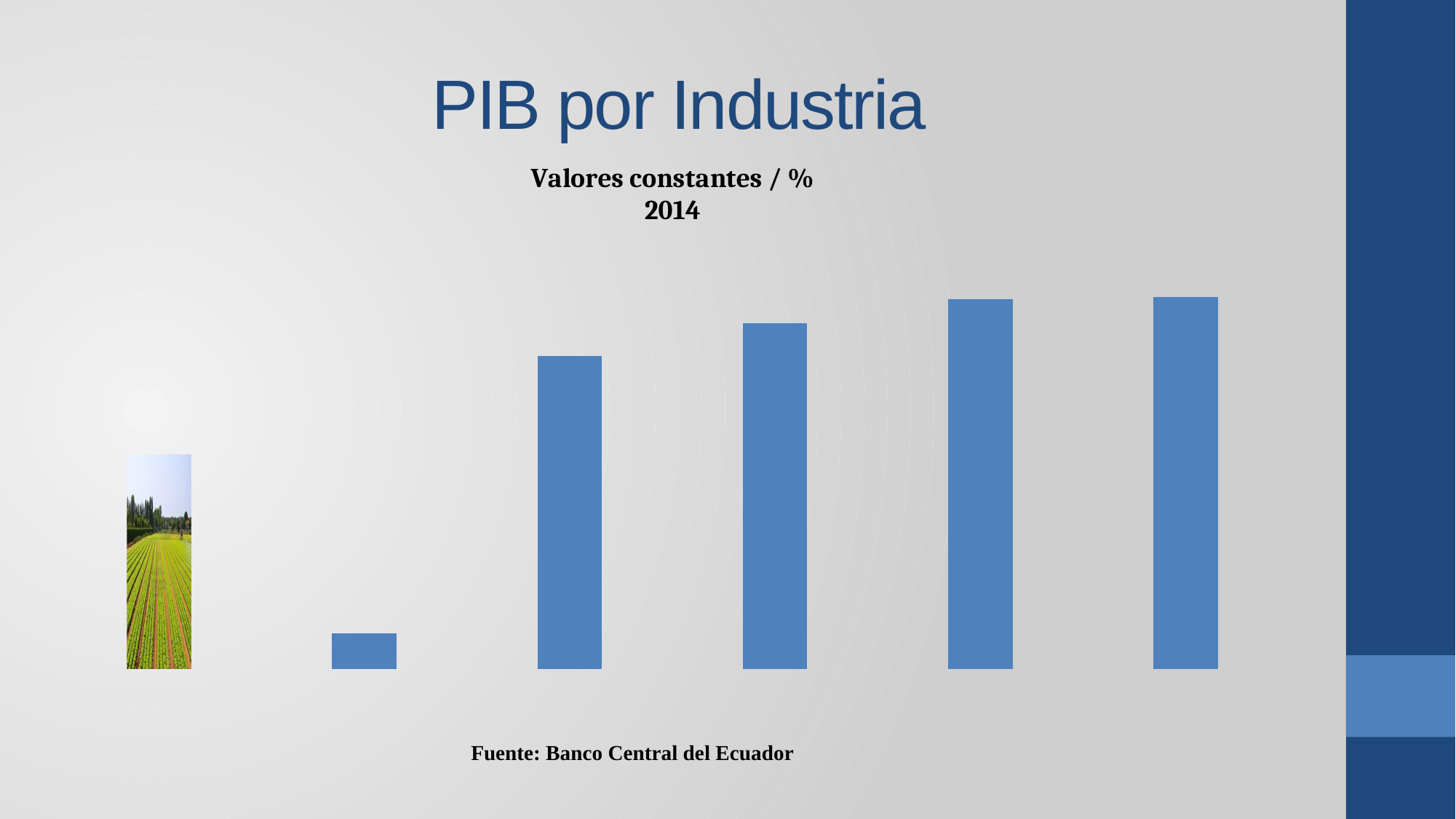
What kind of chart is shown on the slide? bar chart Which is taller, the first bar from the left (the one filled with a field image) or the second bar? the first bar What is the title of the slide containing the chart? PIB por Industria Which bar, by position from the left, is the shortest in the chart? the second bar Which is taller, the third bar from the left or the fourth bar from the left? the fourth bar What source is cited below the chart? Banco Central del Ecuador From the second bar onward, do the bar heights rise or fall moving left to right? rise How many bars does the chart contain? 6